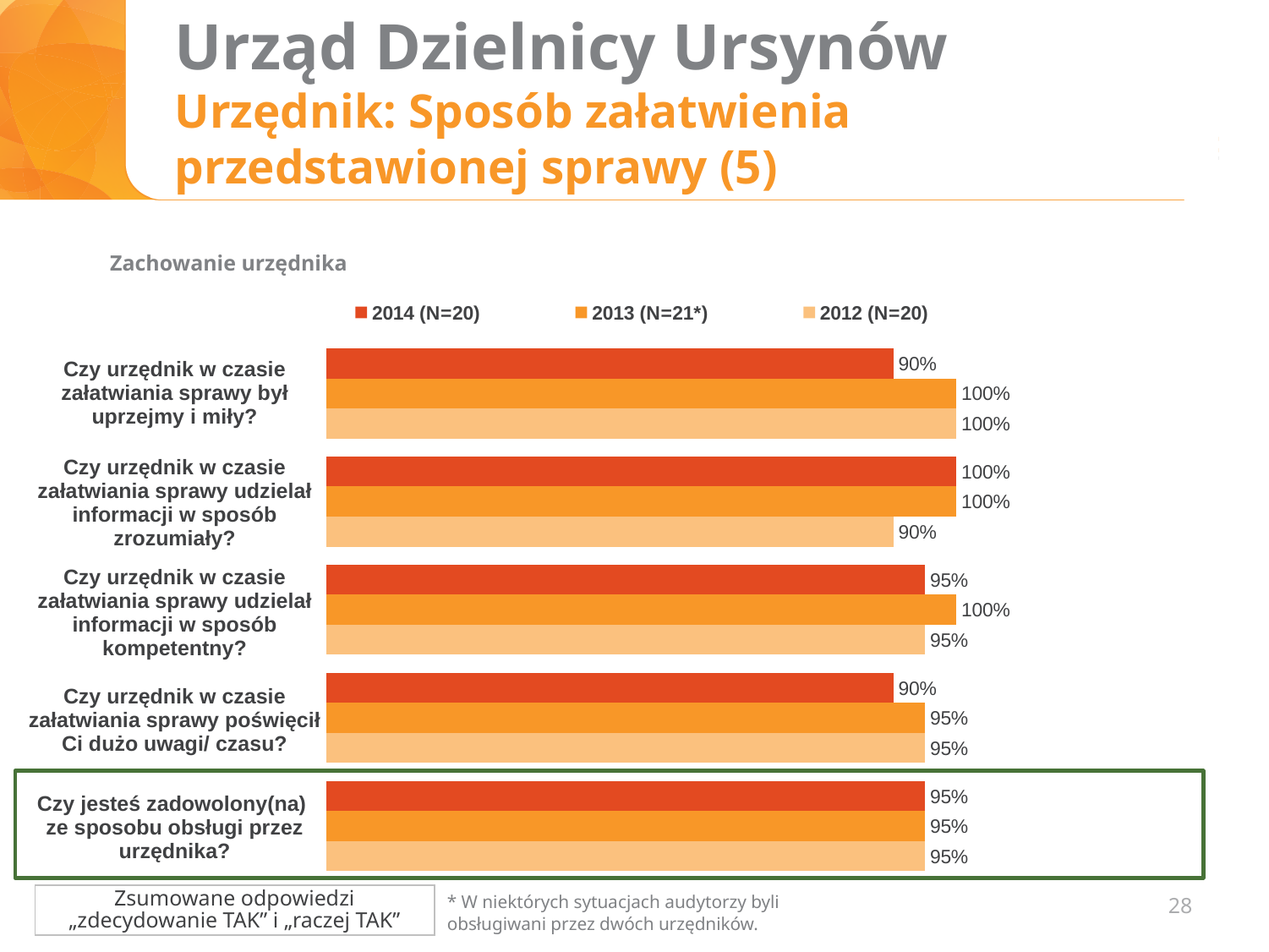
What is the 2014 (N=20) value for "Czy urzędnik w czasie załatwiania sprawy był uprzejmy i miły?"? 90% What kind of chart is shown on the slide? Bar chart What is the 2013 (N=21*) value for "Czy urzędnik w czasie załatwiania sprawy udzielał informacji w sposób kompetentny?"? 100% How many series does the legend list? 3 What is the title shown above the chart? Zachowanie urzędnika What is the 2012 (N=20) value for "Czy urzędnik w czasie załatwiania sprawy udzielał informacji w sposób zrozumiały?"? 90% What is the difference between the 2013 (N=21*) and 2012 (N=20) values for "Czy urzędnik w czasie załatwiania sprawy udzielał informacji w sposób kompetentny?"? 5% How many question categories are shown in the chart? 5 What is the difference between the 2013 (N=21*) and 2014 (N=20) values for "Czy urzędnik w czasie załatwiania sprawy był uprzejmy i miły?"? 10% What is the 2014 (N=20) value for "Czy jesteś zadowolony(na) ze sposobu obsługi przez urzędnika?"? 95% For "Czy urzędnik w czasie załatwiania sprawy poświęcił Ci dużo uwagi/ czasu?", which is larger: the 2014 (N=20) value or the 2013 (N=21*) value? 2013 (N=21*) Which series has the lowest value for "Czy urzędnik w czasie załatwiania sprawy udzielał informacji w sposób zrozumiały?"? 2012 (N=20)